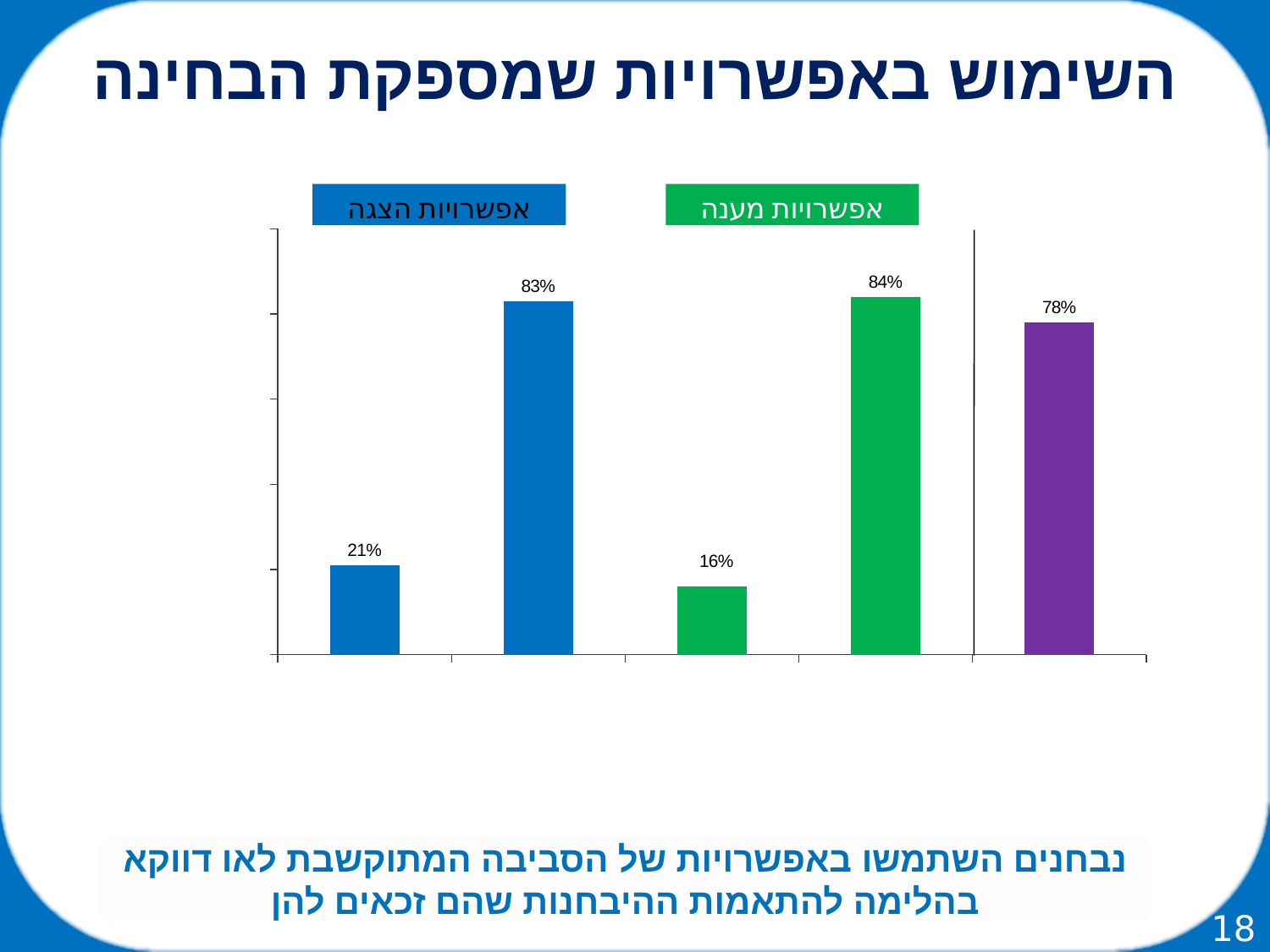
What is the value of the shorter green bar under "אפשרויות מענה"? 16% What colour are the bars under the label "אפשרויות מענה"? green How many bars are plotted in the chart? 5 What is the highest value shown in the chart? 84% What is the difference between the two blue bars (83% and 21%)? 62% What is the value of the leftmost blue bar under "אפשרויות הצגה"? 21% What kind of chart is shown on the slide? bar chart What is the difference between the two green bars (84% and 16%)? 68% What is the value of the taller blue bar under "אפשרויות הצגה"? 83% Which is larger: the taller green bar or the purple bar? the taller green bar (84%) What is the lowest value shown in the chart? 16% What is the value of the purple bar on the right of the chart? 78%